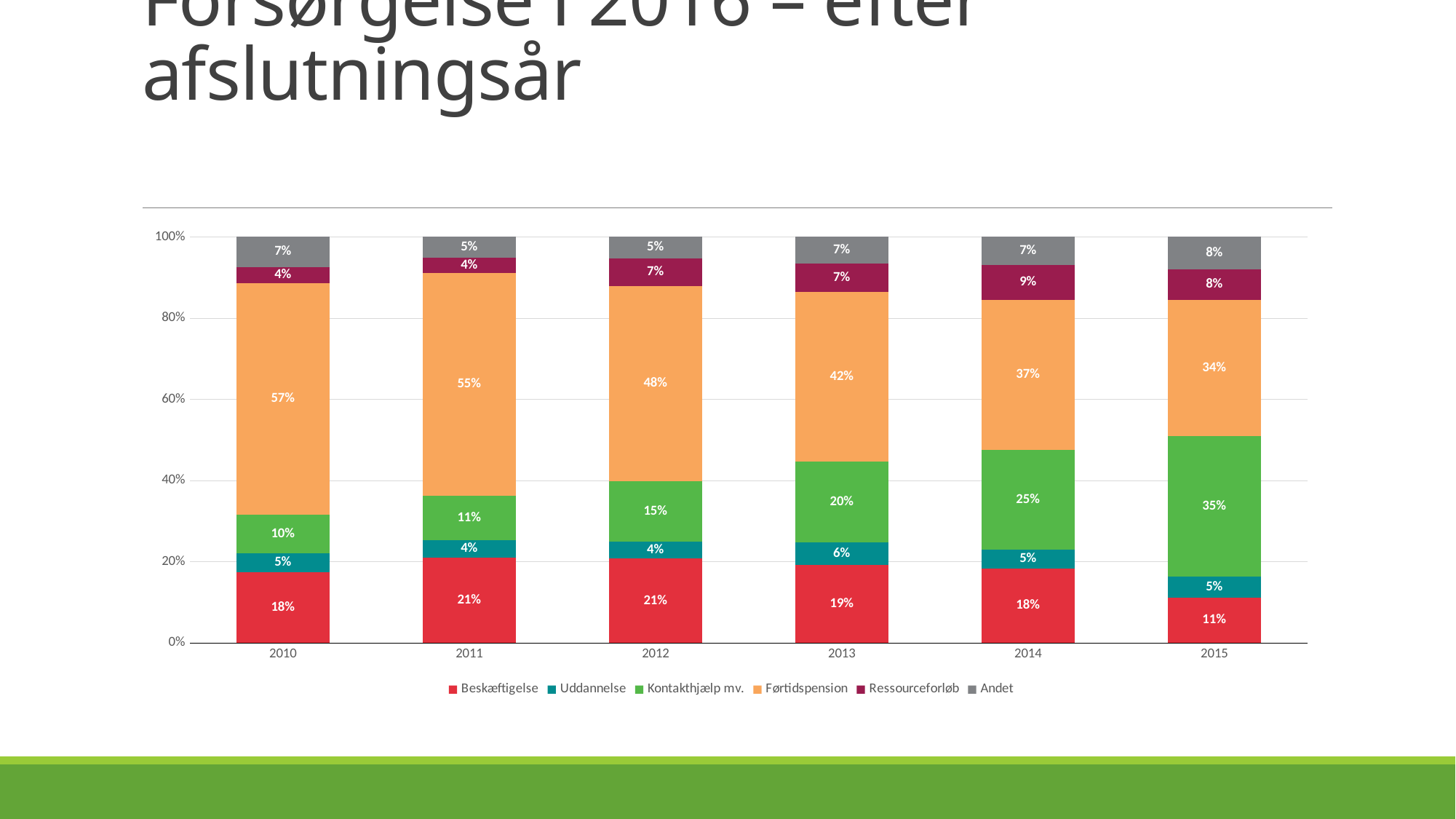
In which year is the Beskæftigelse share lowest? 2015 How many years are shown on the x axis? 6 In which year is the Førtidspension share highest? 2010 What is the value for Førtidspension in 2010? 57% What is the value for Beskæftigelse in 2012? 21% What is the value for Ressourceforløb in 2014? 9% What is the value for Kontakthjælp mv. in 2015? 35% Which is larger in 2013: Kontakthjælp mv. or Førtidspension? Førtidspension What is the difference between the Førtidspension share in 2010 and in 2015? 23% Does the Kontakthjælp mv. share rise or fall from 2010 to 2015? Rise What kind of chart is shown on the slide? Stacked bar chart How many series does the legend list? 6